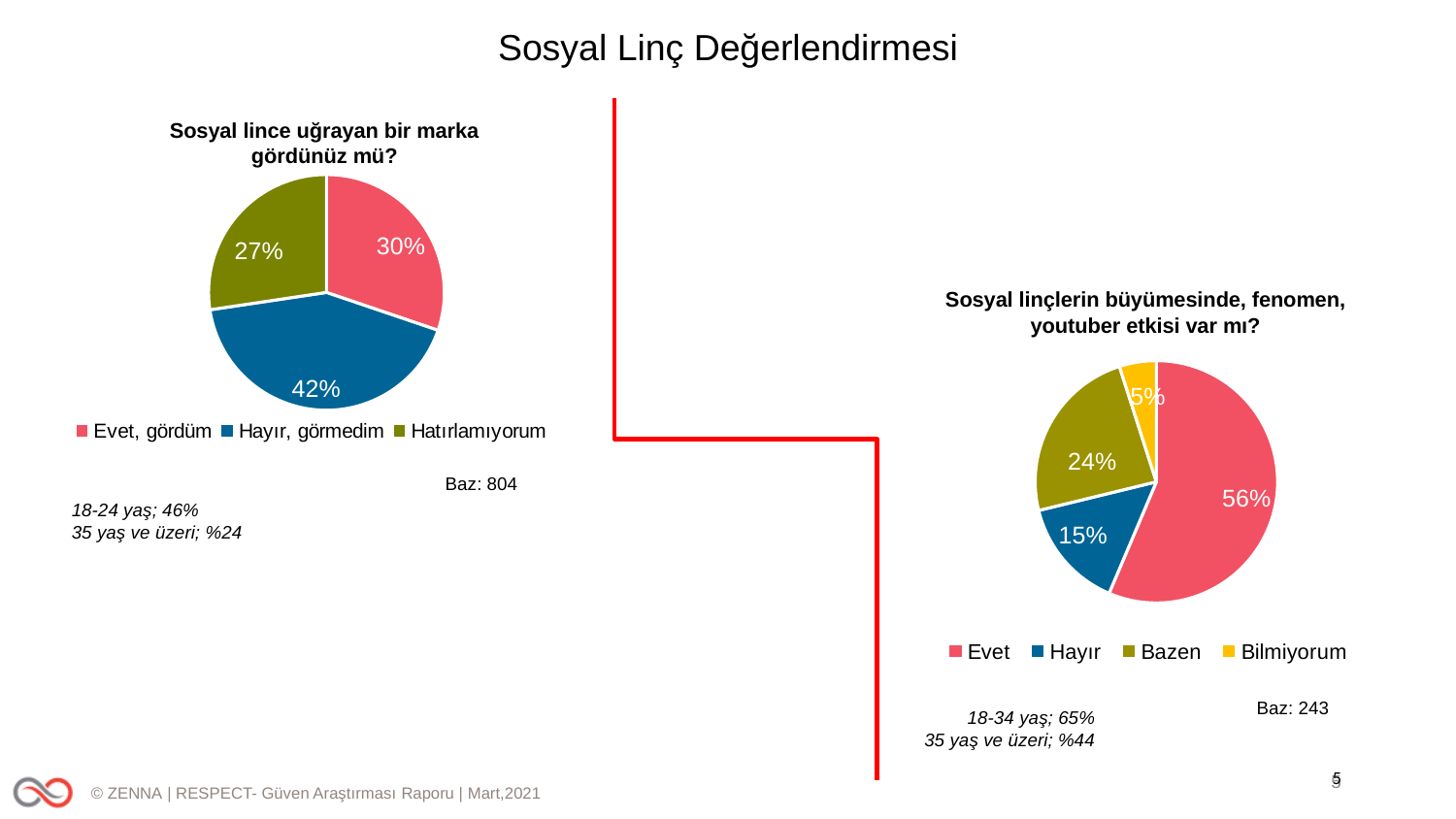
In the chart titled "Sosyal lince uğrayan bir marka gördünüz mü?", what share is labelled for "Hayır, görmedim"? 42% In the chart titled "Sosyal lince uğrayan bir marka gördünüz mü?", how many categories does the legend list? 3 In the chart titled "Sosyal linçlerin büyümesinde, fenomen, youtuber etkisi var mı?", what share is labelled for "Evet"? 56% In the chart titled "Sosyal lince uğrayan bir marka gördünüz mü?", what is the difference in percentage points between "Hayır, görmedim" and "Evet, gördüm"? 12 percentage points In the chart titled "Sosyal linçlerin büyümesinde, fenomen, youtuber etkisi var mı?", which category has the smallest slice? Bilmiyorum In the chart titled "Sosyal linçlerin büyümesinde, fenomen, youtuber etkisi var mı?", what share is labelled for "Bazen"? 24% In the chart titled "Sosyal lince uğrayan bir marka gördünüz mü?", what share is labelled for "Evet, gördüm"? 30% In the chart titled "Sosyal lince uğrayan bir marka gördünüz mü?", which category has the largest slice? Hayır, görmedim In the chart titled "Sosyal linçlerin büyümesinde, fenomen, youtuber etkisi var mı?", how many categories does the legend list? 4 In the chart titled "Sosyal linçlerin büyümesinde, fenomen, youtuber etkisi var mı?", which is larger, "Hayır" or "Bazen"? Bazen What type of chart is used for "Sosyal linçlerin büyümesinde, fenomen, youtuber etkisi var mı?"? Pie chart In the chart titled "Sosyal lince uğrayan bir marka gördünüz mü?", which category has the smallest slice? Hatırlamıyorum